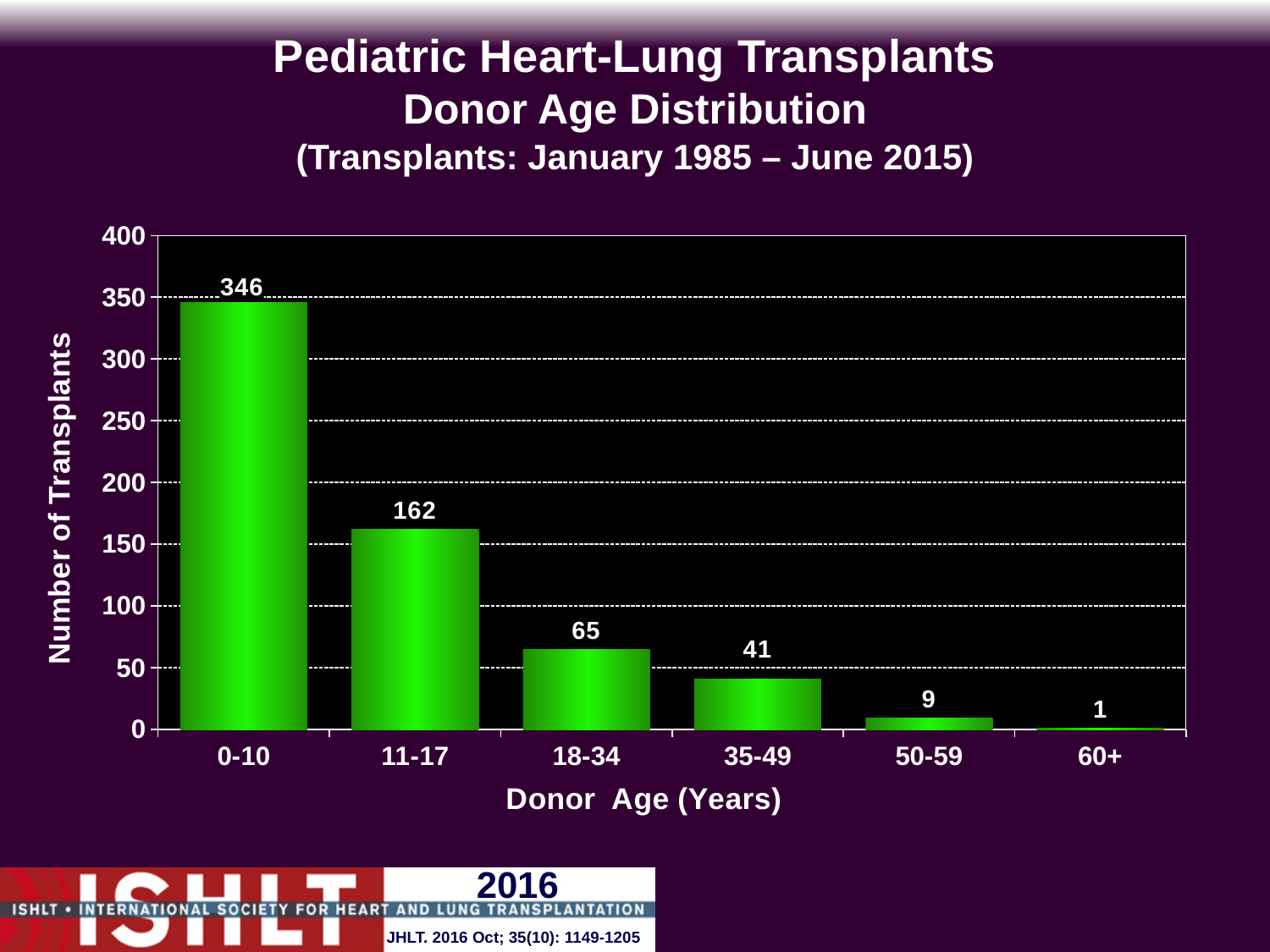
What is the difference in number of transplants between donor age 0-10 and 11-17? 184 What is the number of transplants for donor age 0-10? 346 Is the value for donor age 11-17 greater or less than 150? greater Which donor age group has the highest number of transplants? 0-10 What is the difference in number of transplants between donor age 18-34 and 35-49? 24 What is the number of transplants for donor age 18-34? 65 What is the number of transplants for donor age 50-59? 9 What kind of chart is shown on the slide? bar chart Which donor age group has the lowest number of transplants? 60+ Which has more transplants, donor age 11-17 or 35-49? 11-17 Do the values rise or fall as donor age increases along the x axis? fall How many donor age groups are shown on the x axis? 6